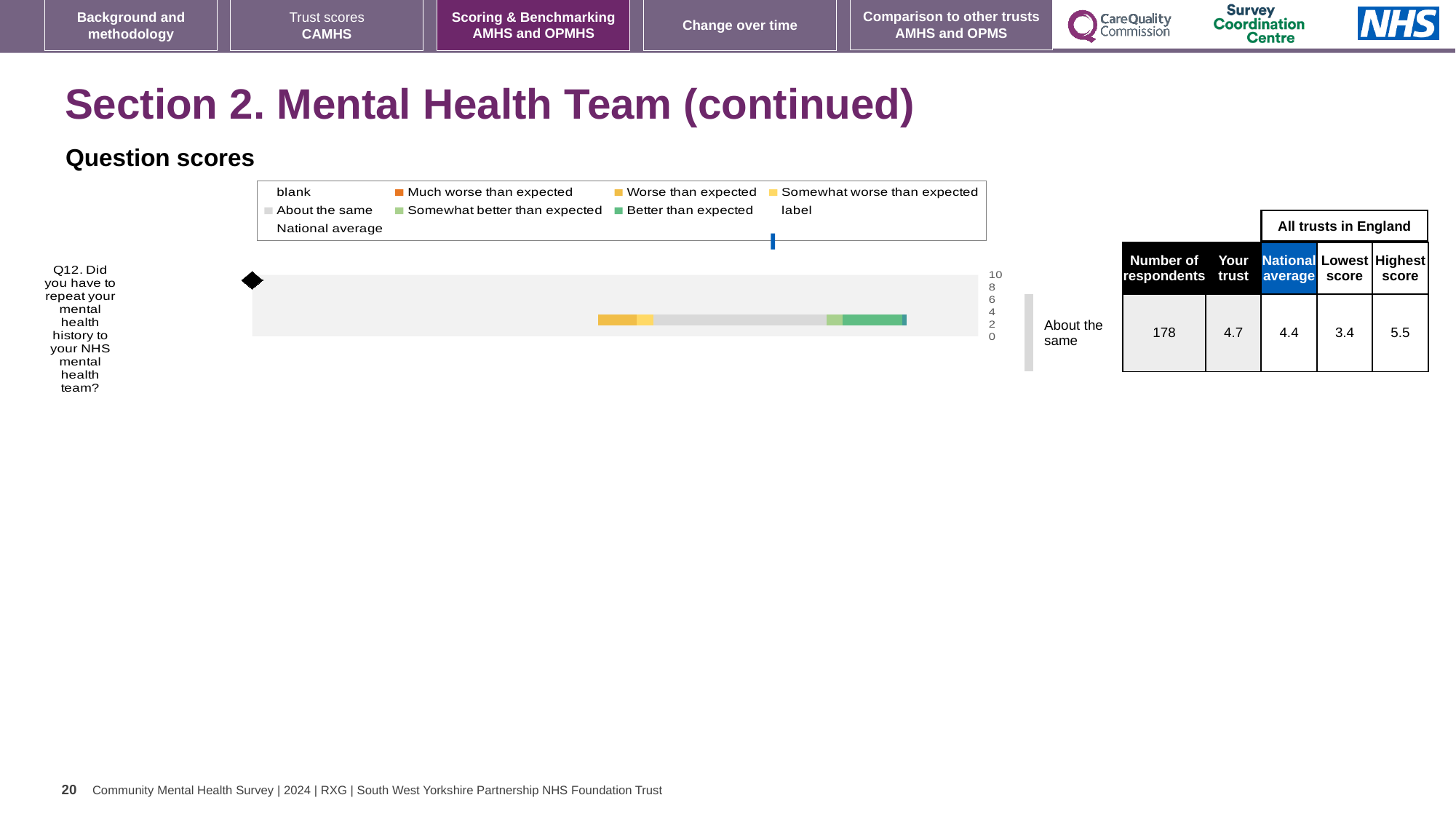
What is the difference between the highest score and the lowest score for Q12 in the table? 2.1 What benchmark label is shown to the right of the Q12 bar? About the same What kind of chart is shown on the slide for Q12? bar chart Is the 'Your trust' score for Q12 larger or smaller than the national average? larger What is the highest tick value shown on the chart's axis? 10 How many questions (categories) are plotted in the chart? 1 In the table beside the chart, what is the national average for Q12? 4.4 In the table beside the chart, what is the highest score among all trusts in England for Q12? 5.5 In the table beside the chart, what is the 'Your trust' score for Q12? 4.7 In the table beside the chart, what is the lowest score among all trusts in England for Q12? 3.4 Which question is plotted in the chart? Q12. Did you have to repeat your mental health history to your NHS mental health team? In the table beside the chart, what is the number of respondents for Q12? 178